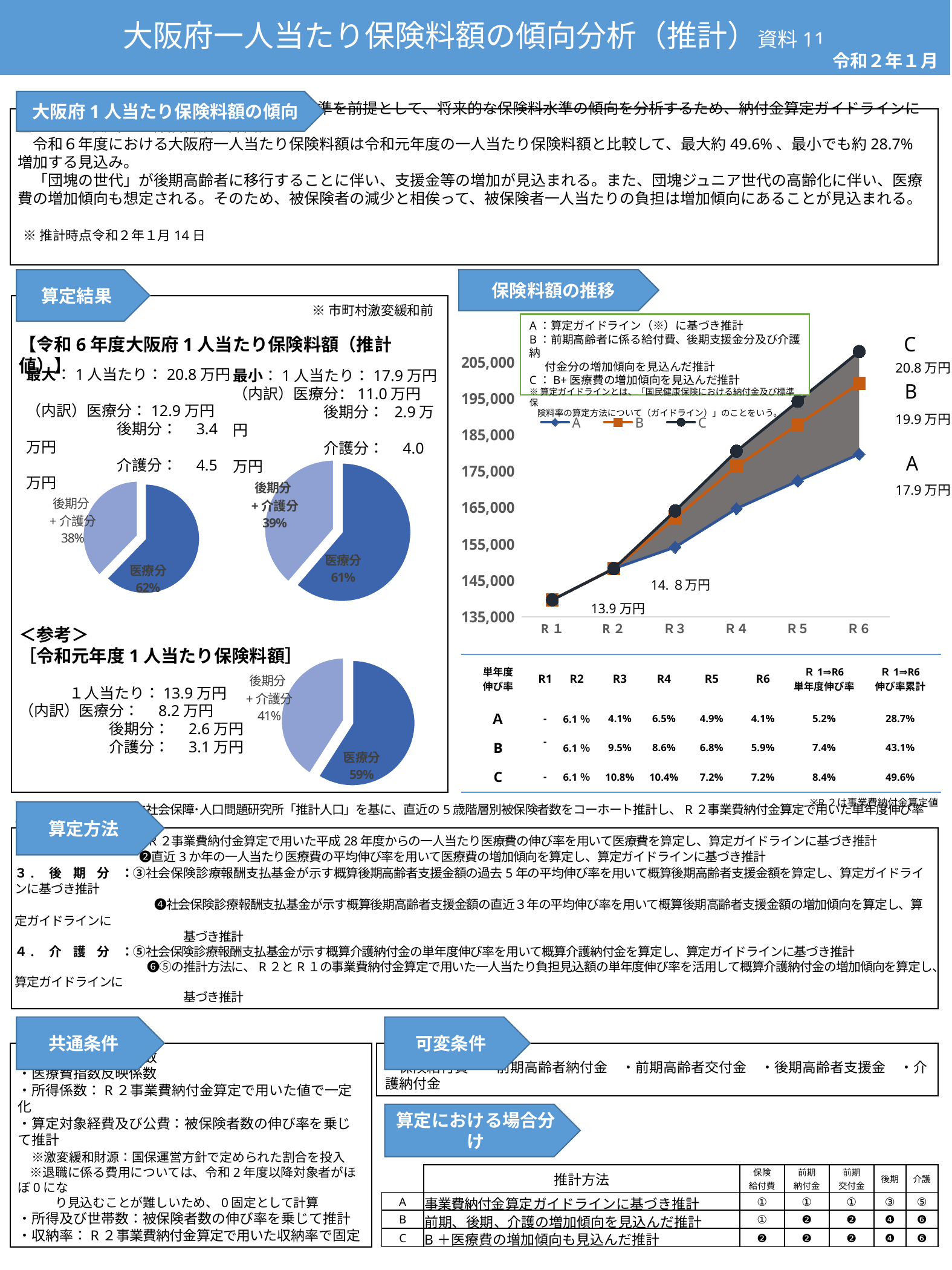
In the 保険料額の推移 line chart, which series has the highest value at R6? C In the 保険料額の推移 line chart, what value is labelled for series C at R6? 20.8万円 How many series does the legend of the 保険料額の推移 line chart list? 3 In the 最大 pie chart under 算定結果 (left pie), what share is 医療分? 62% In the 保険料額の推移 line chart, which series has the lowest value at R6? A In the 保険料額の推移 line chart, at R6, which is larger: series B or series A? B In the 保険料額の推移 line chart, do the values rise or fall from R1 to R6? rise How many points (fiscal years) are shown along the x axis of the 保険料額の推移 line chart? 6 What kind of chart is the 保険料額の推移 chart on the right side of the slide? line chart In the 保険料額の推移 line chart, what value is labelled at R1? 13.9万円 In the 令和元年度1人当たり保険料額 pie chart at the bottom left, what share is 後期分+介護分? 41% In the 保険料額の推移 line chart, is the value for series A at R6 greater or less than 175,000? greater